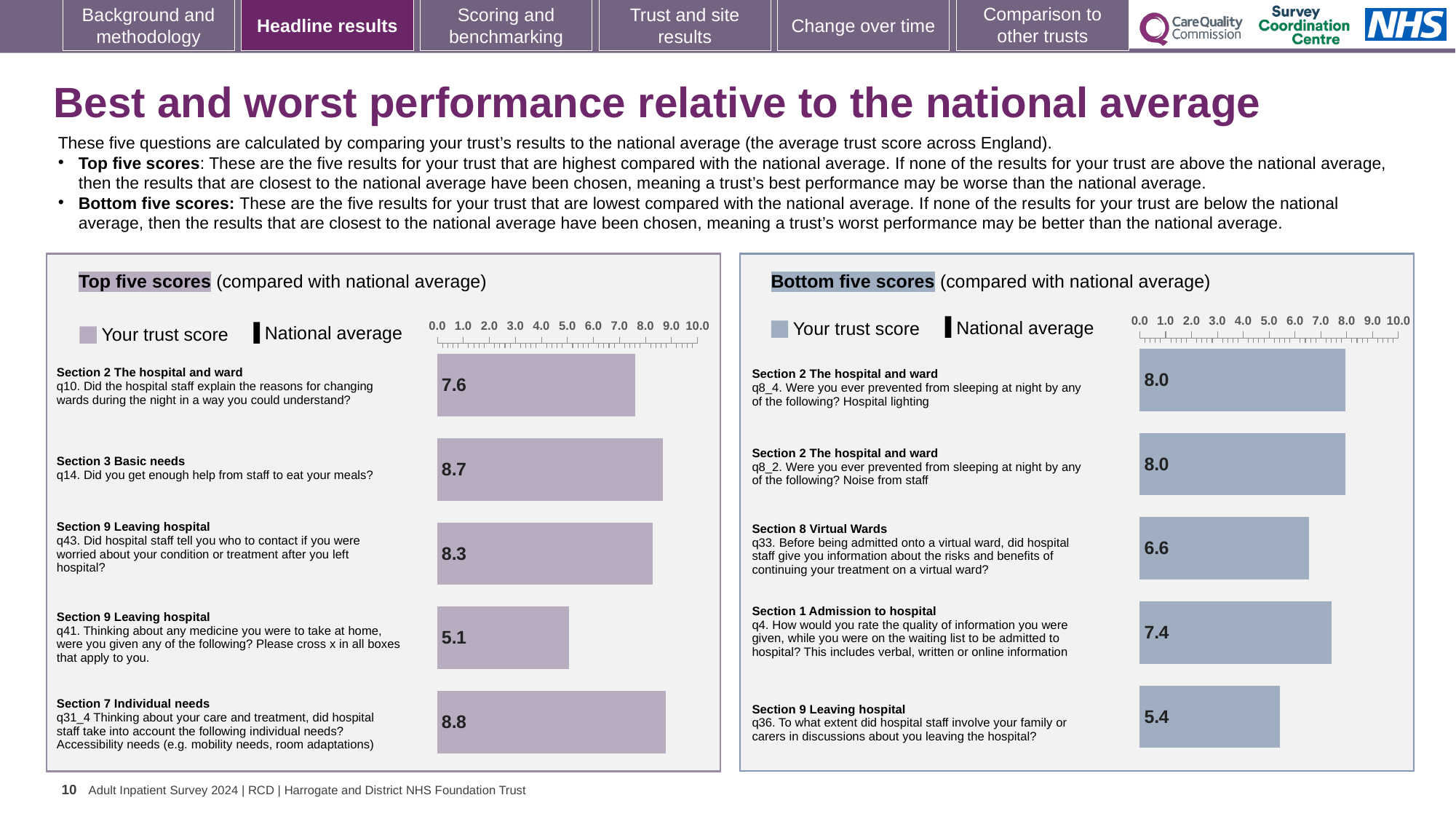
In the 'Bottom five scores' chart, is the trust score for q4 larger or smaller than the score for q36? larger In the 'Bottom five scores' chart, what is the difference between the trust scores for q4 and q33? 0.8 In the 'Bottom five scores' chart, what is the trust score for q36 about involving family or carers in discussions about leaving hospital? 5.4 In the 'Top five scores' chart, which question has the lowest trust score? q41 (medicine to take at home), 5.1 In the 'Top five scores' chart, what is the trust score for q14 (Did you get enough help from staff to eat your meals?)? 8.7 In the 'Bottom five scores' chart, what is the trust score for q33 about information on the risks and benefits of a virtual ward? 6.6 In the 'Bottom five scores' chart, which question has the lowest trust score? q36 (involving family or carers), 5.4 In the 'Top five scores' chart, what is the difference between the highest trust score (q31_4) and the lowest trust score (q41)? 3.7 How many questions are plotted in the 'Bottom five scores' chart? 5 In the 'Top five scores' chart, what is the trust score for q10 about staff explaining the reasons for changing wards during the night? 7.6 In the 'Top five scores' chart, which question has the highest trust score? q31_4 (Accessibility needs), 8.8 What type of chart is used in the 'Top five scores' panel? bar chart